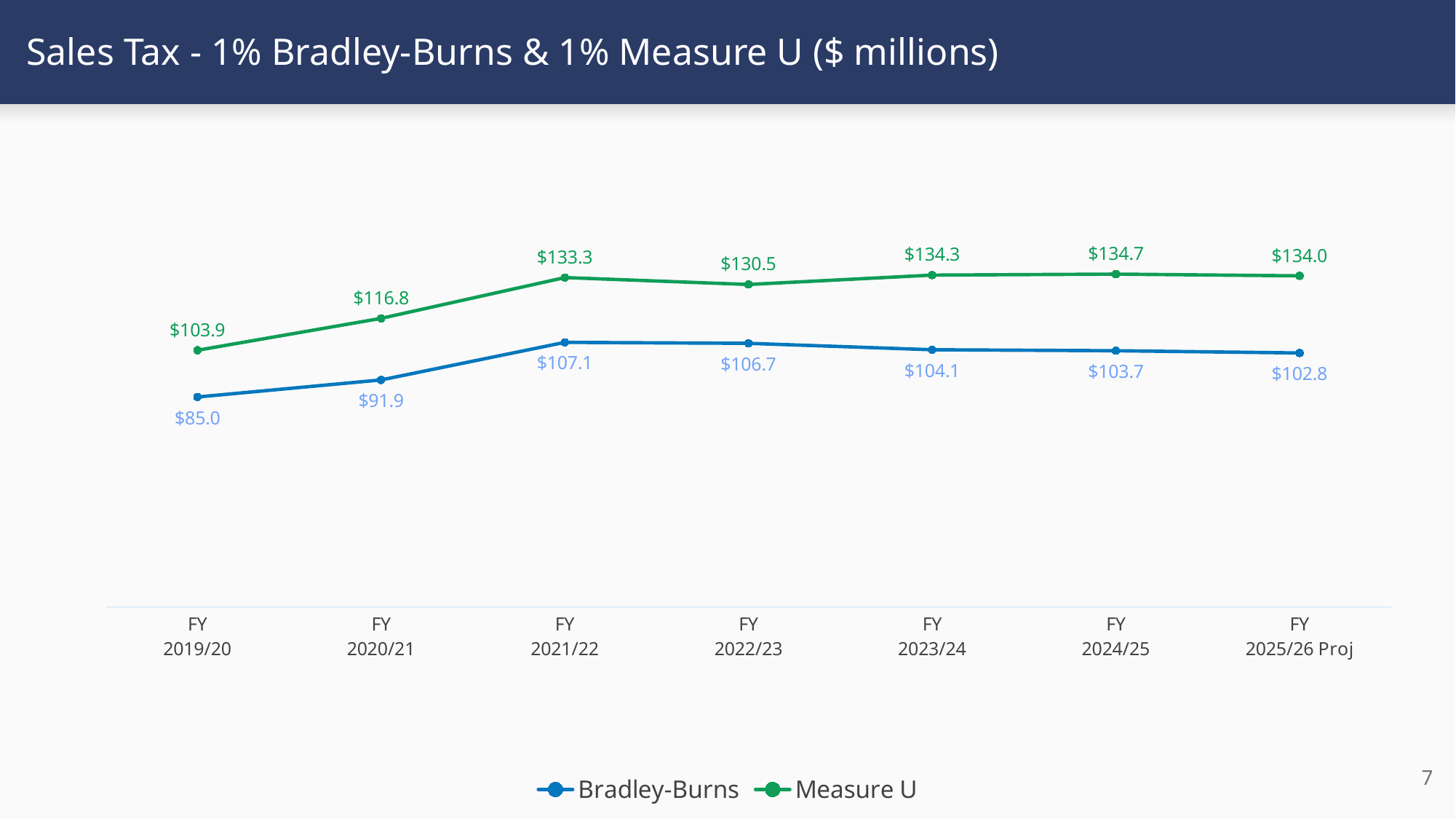
What kind of chart is shown on the slide? Line chart What is the difference between the Measure U and Bradley-Burns values in FY 2021/22? $26.2 Which colour is used for the Measure U series? Green What is the Bradley-Burns value for FY 2019/20? $85.0 What is the Measure U value for FY 2022/23? $130.5 Which is larger, the Bradley-Burns value for FY 2020/21 or for FY 2022/23? FY 2022/23 In which fiscal year is the Bradley-Burns value lowest? FY 2019/20 Does the Measure U series rise or fall from FY 2019/20 to FY 2021/22? Rise In which fiscal year is the Measure U value highest? FY 2024/25 How many series does the legend list? 2 What is the Bradley-Burns value for FY 2025/26 Proj? $102.8 How many fiscal years are plotted on the x axis? 7